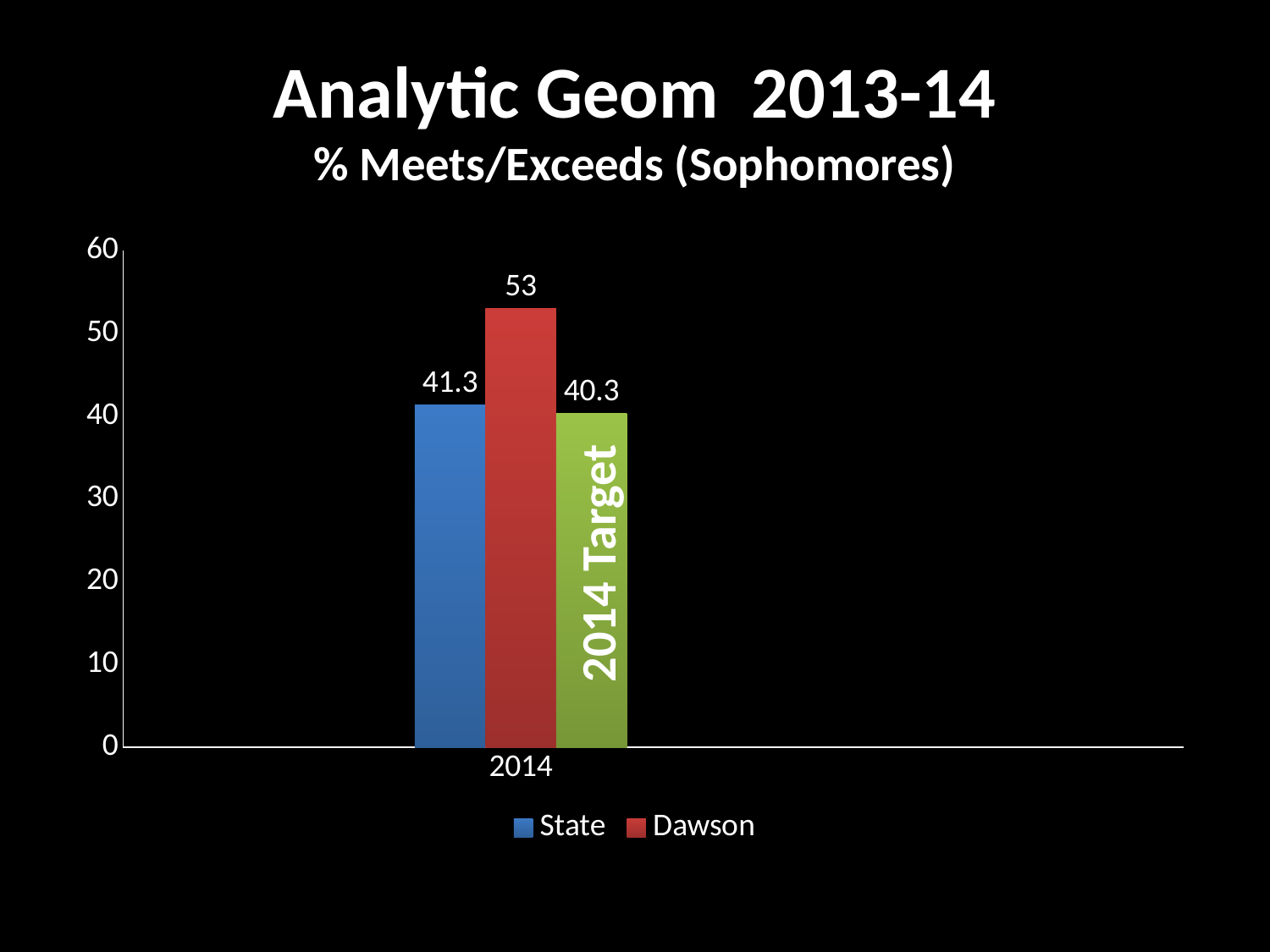
Which bar is the highest? Dawson What is the difference between the Dawson value and the State value? 11.7 What is the value for Dawson in 2014? 53 Which is larger, the State value or the Dawson value? Dawson What kind of chart is shown on the slide? bar chart What is the value of the 2014 Target bar? 40.3 Is the value for Dawson greater or less than 50? greater How many series does the legend list? 2 What is the difference between the Dawson value and the 2014 Target? 12.7 Which bar is the lowest? 2014 Target What is the value for State in 2014? 41.3 What is the title of the chart? Analytic Geom 2013-14 % Meets/Exceeds (Sophomores)